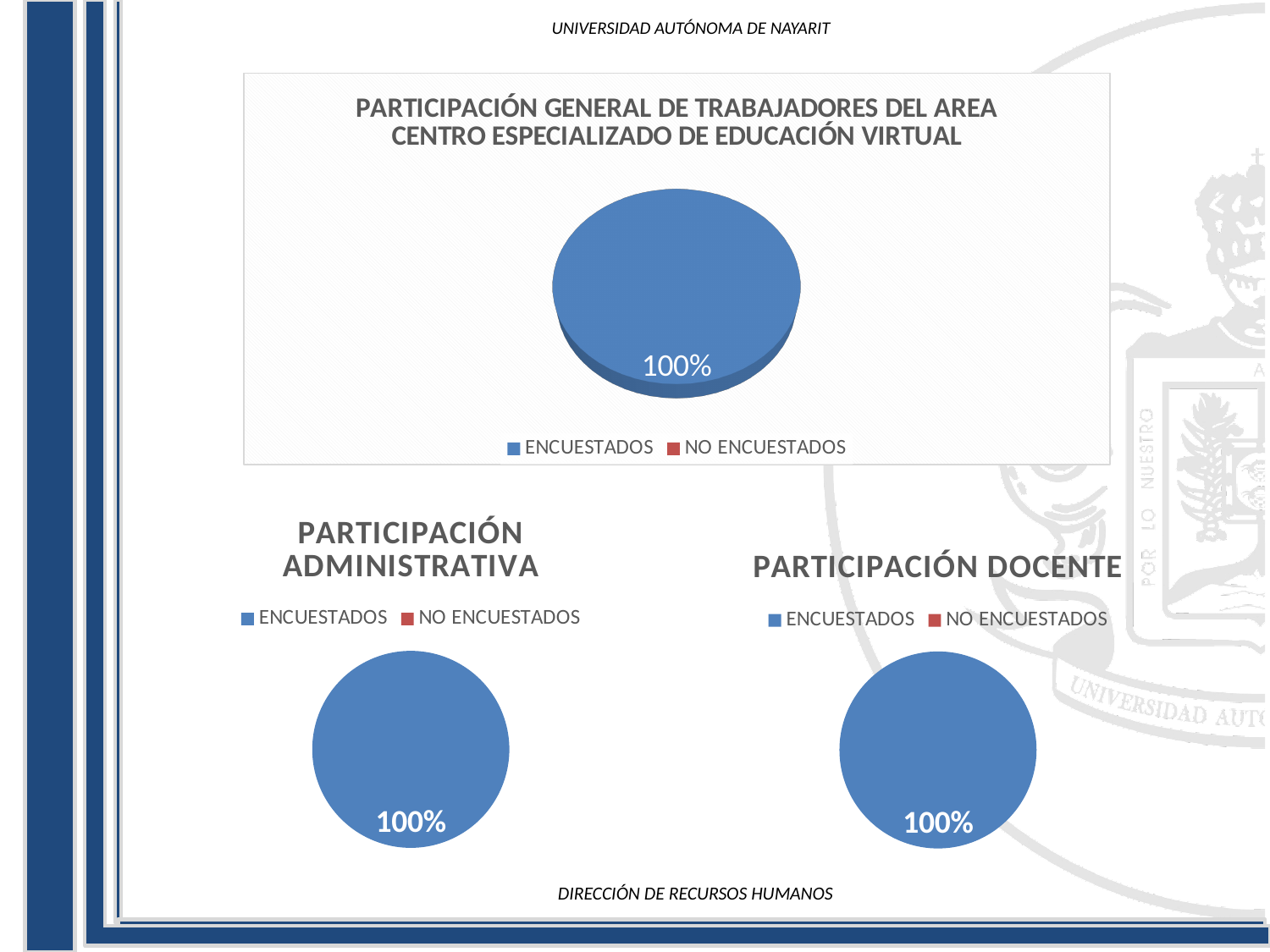
What kind of chart is the top chart titled 'PARTICIPACIÓN GENERAL DE TRABAJADORES DEL AREA CENTRO ESPECIALIZADO DE EDUCACIÓN VIRTUAL'? pie chart In the chart titled 'PARTICIPACIÓN DOCENTE', what percentage is shown on the pie? 100% What is the title of the chart at the bottom left of the slide? PARTICIPACIÓN ADMINISTRATIVA What kind of chart is the chart titled 'PARTICIPACIÓN DOCENTE'? pie chart In the chart titled 'PARTICIPACIÓN ADMINISTRATIVA', what percentage is shown on the pie? 100% In the chart titled 'PARTICIPACIÓN ADMINISTRATIVA', which legend entry does the single visible slice belong to? ENCUESTADOS How many pie charts are shown on the slide? 3 In the chart titled 'PARTICIPACIÓN GENERAL DE TRABAJADORES DEL AREA CENTRO ESPECIALIZADO DE EDUCACIÓN VIRTUAL', what share of the pie is labelled for ENCUESTADOS? 100% In the chart titled 'PARTICIPACIÓN DOCENTE', which legend entry does the single visible slice belong to? ENCUESTADOS How many series does the legend of the chart titled 'PARTICIPACIÓN ADMINISTRATIVA' list? 2 In the chart titled 'PARTICIPACIÓN DOCENTE', what colour is the legend marker for NO ENCUESTADOS? red How many series does the legend of the top chart 'PARTICIPACIÓN GENERAL DE TRABAJADORES DEL AREA CENTRO ESPECIALIZADO DE EDUCACIÓN VIRTUAL' list? 2